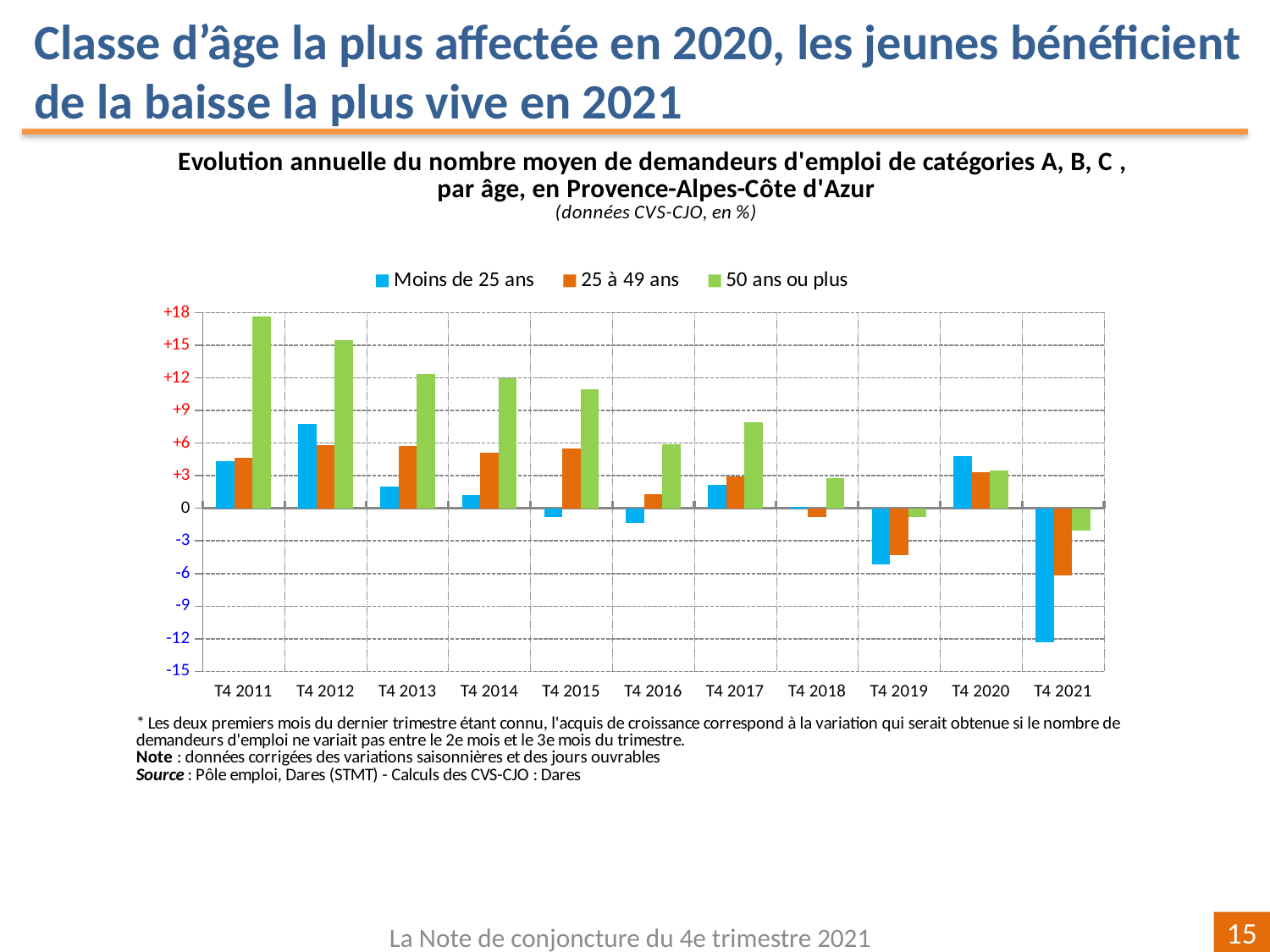
Is the value for '25 à 49 ans' in T4 2021 greater or less than -3? less How many series does the legend list? 3 What colour represents the series 'Moins de 25 ans'? blue In T4 2012, which is larger: the value for 'Moins de 25 ans' or for '25 à 49 ans'? Moins de 25 ans Does the value for '50 ans ou plus' rise or fall from T4 2011 to T4 2016? fall In T4 2021, which is lower: the value for '25 à 49 ans' or for '50 ans ou plus'? 25 à 49 ans How many quarters are shown on the x axis? 11 For the series '50 ans ou plus', which quarter has the highest value? T4 2011 Is the value for '50 ans ou plus' in T4 2011 greater or less than +15? greater For the series 'Moins de 25 ans', which quarter has the lowest value? T4 2021 What kind of chart is shown on the slide? bar chart Is the value for 'Moins de 25 ans' in T4 2021 greater or less than -9? less